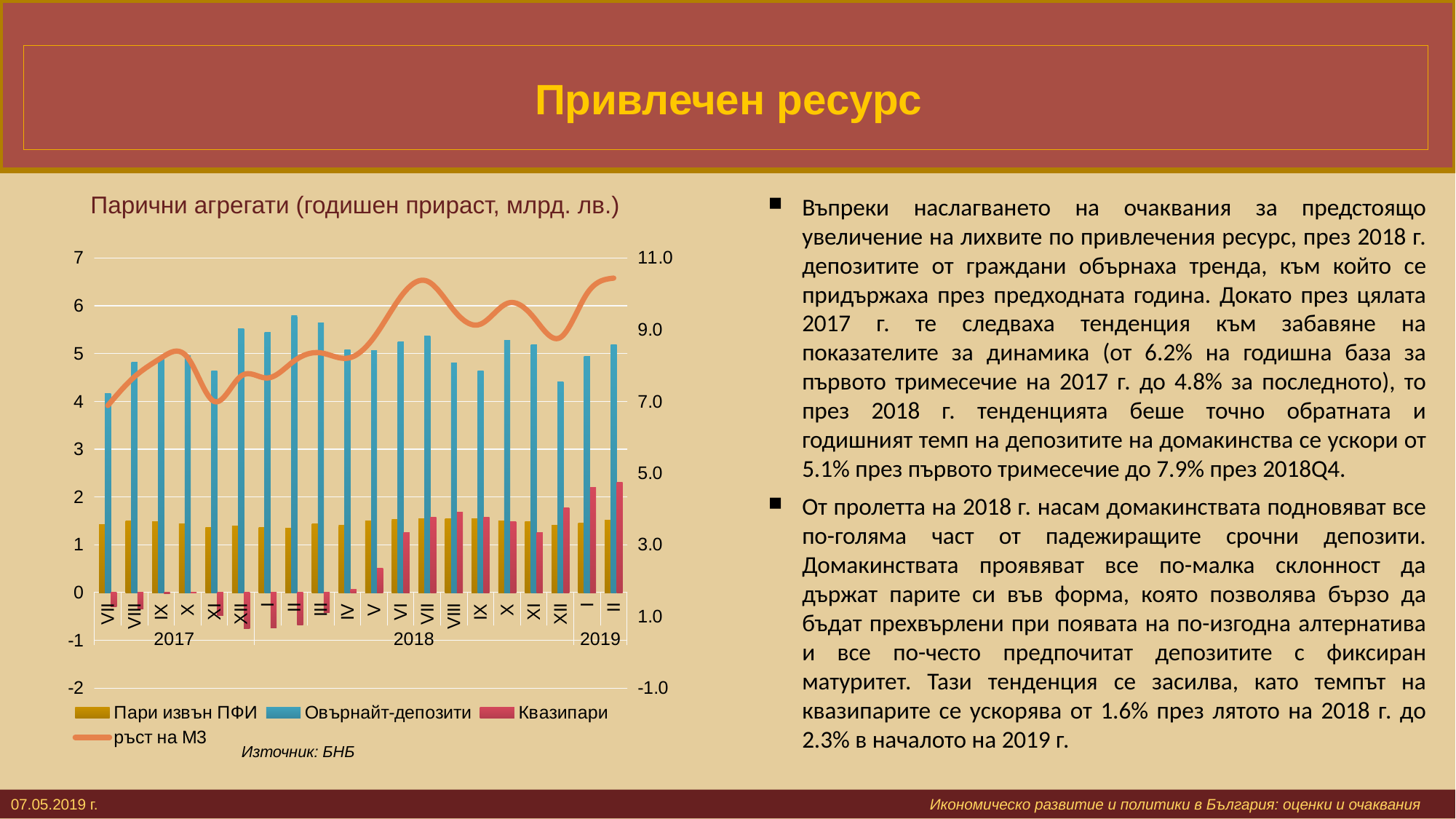
Is the value of ръст на М3 for II 2019 greater or less than 9.0 on the right-hand axis? greater Do the Квазипари values rise or fall from VI 2018 to II 2019? rise Is the value of Пари извън ПФИ for VII 2017 greater or less than 2? less Is the value of Квазипари for I 2018 greater or less than 0? less What kind of chart is shown on the slide? A combined bar and line chart How many monthly categories are plotted along the x axis of the chart? 20 Which is larger, the Овърнайт-депозити value for II 2018 or for XII 2018? II 2018 How many series does the chart legend list? 4 What source is cited below the chart? БНБ What is the title of the chart? Парични агрегати (годишен прираст, млрд. лв.)